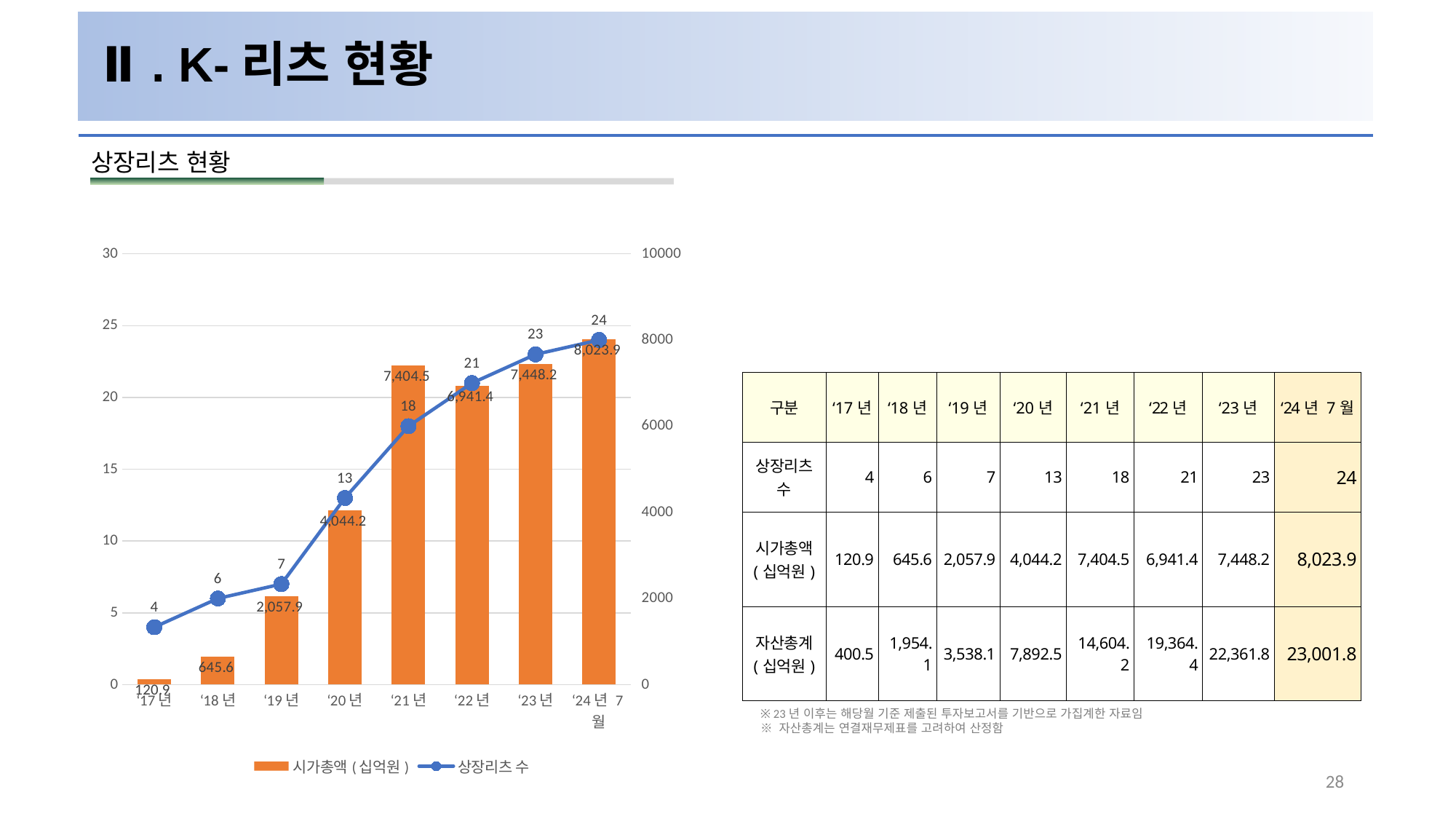
What is the difference in 시가총액 (십억원) between '23 년 and '22 년? 506.8 What kind of chart is shown on the slide? Combined bar and line chart Which series is shown as orange bars in the chart? 시가총액 (십억원) How many categories are shown on the x axis of the chart? 8 Does the 상장리츠 수 series rise or fall from '17 년 to '24 년 7 월? Rise What is the 시가총액 (십억원) value for '21 년? 7,404.5 Which category has the lowest 상장리츠 수 value? '17 년 Which is larger, the 시가총액 (십억원) for '21 년 or for '22 년? '21 년 What is the difference in 상장리츠 수 between '24 년 7 월 and '17 년? 20 Which category has the highest 시가총액 (십억원) value? '24 년 7 월 What is the 상장리츠 수 value for '20 년? 13 How many series does the chart legend list? 2